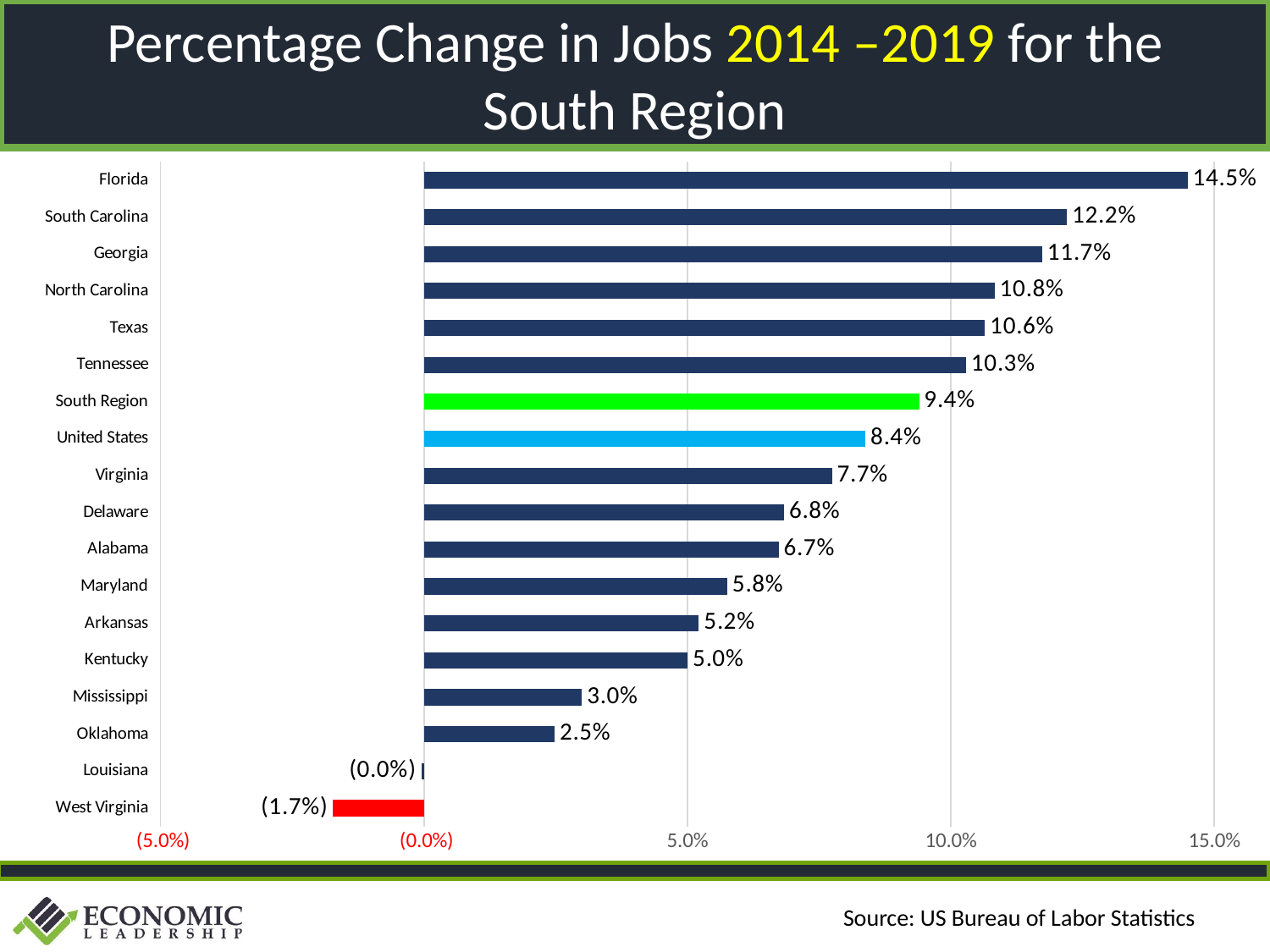
Is the value for Georgia greater or less than 10.0%? greater What is the title of the chart? Percentage Change in Jobs 2014 –2019 for the South Region What kind of chart is shown on the slide? Bar chart What is the percentage change in jobs for the United States? 8.4% Which category has the highest percentage change in jobs? Florida What is the percentage change in jobs for Florida? 14.5% What is the percentage change in jobs for West Virginia? (1.7%) What is the percentage change in jobs for the South Region? 9.4% Which has a larger percentage change in jobs, Texas or Tennessee? Texas How many categories are shown on the chart? 18 Which category has the lowest percentage change in jobs? West Virginia What is the difference between the percentage change for Florida and South Carolina? 2.3%